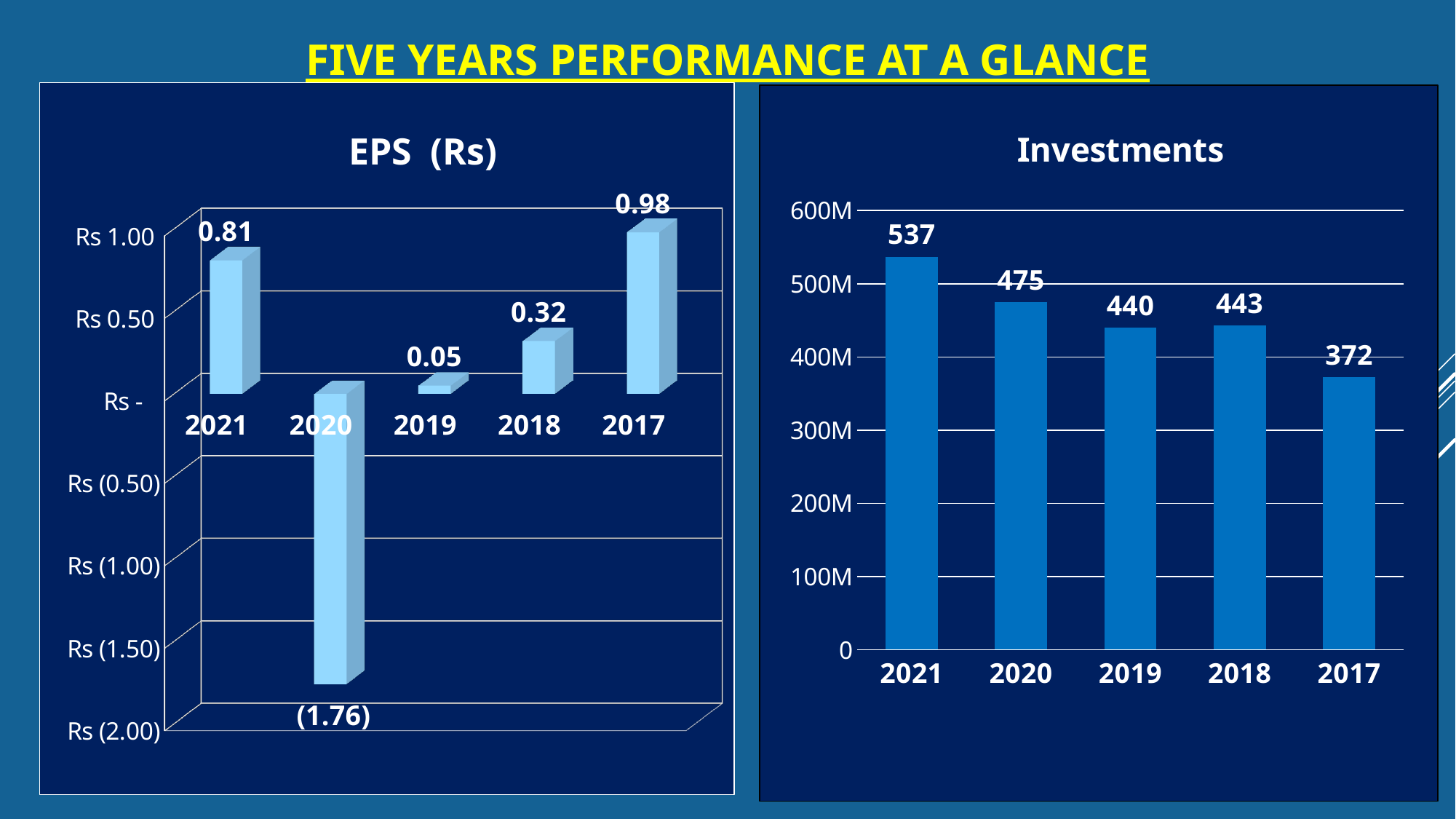
In the EPS (Rs) chart, what is the value for 2020? (1.76) What kind of chart is the Investments chart? Bar chart In the Investments chart, what is the difference between the values for 2021 and 2020? 62 In the EPS (Rs) chart, which year has the lowest value? 2020 In the Investments chart, what is the value for 2019? 440 In the EPS (Rs) chart, which year has the highest value? 2017 In the Investments chart, which year has the lowest value? 2017 In the EPS (Rs) chart, what is the difference between the values for 2017 and 2018? 0.66 In the EPS (Rs) chart, what is the value for 2021? 0.81 In the Investments chart, which year has the highest value? 2021 In the EPS (Rs) chart, how many years are shown? 5 In the Investments chart, is the value for 2018 larger than the value for 2019? Yes